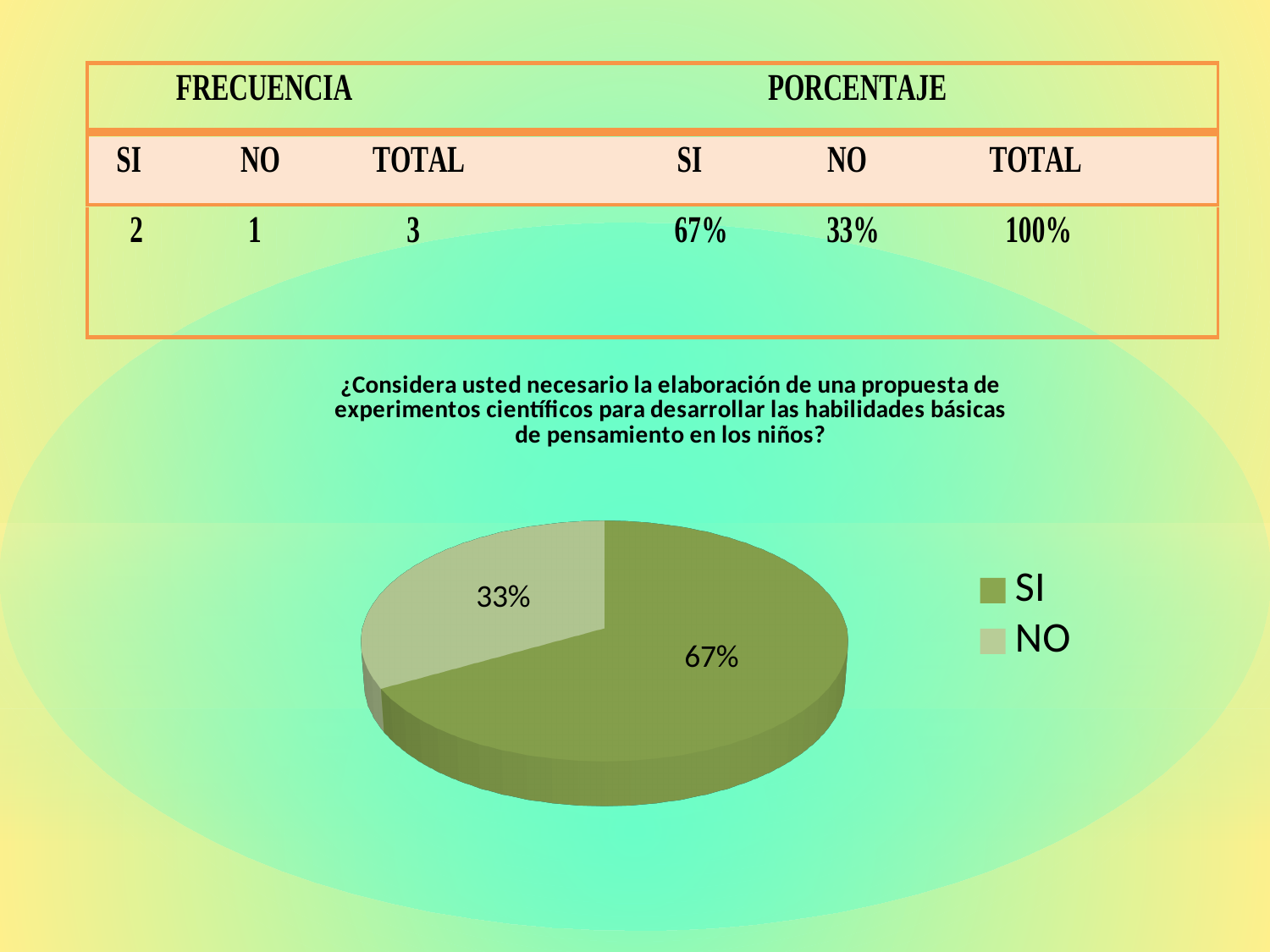
Which slice is larger, SI or NO? SI How many slices does the pie chart have? 2 What is the difference in percentage points between the SI and NO slices? 34 Which category has the largest slice in the pie chart? SI What kind of chart is shown on the slide? pie chart How many entries does the legend of the pie chart list? 2 Which legend entry is shown in the darker olive green colour? SI What percentage is shown for the SI slice of the pie chart? 67% Which category has the smallest slice in the pie chart? NO What percentage is shown for the NO slice of the pie chart? 33% Is the share for SI greater or less than 50%? greater What is the share of the pie taken by the NO slice? 33%